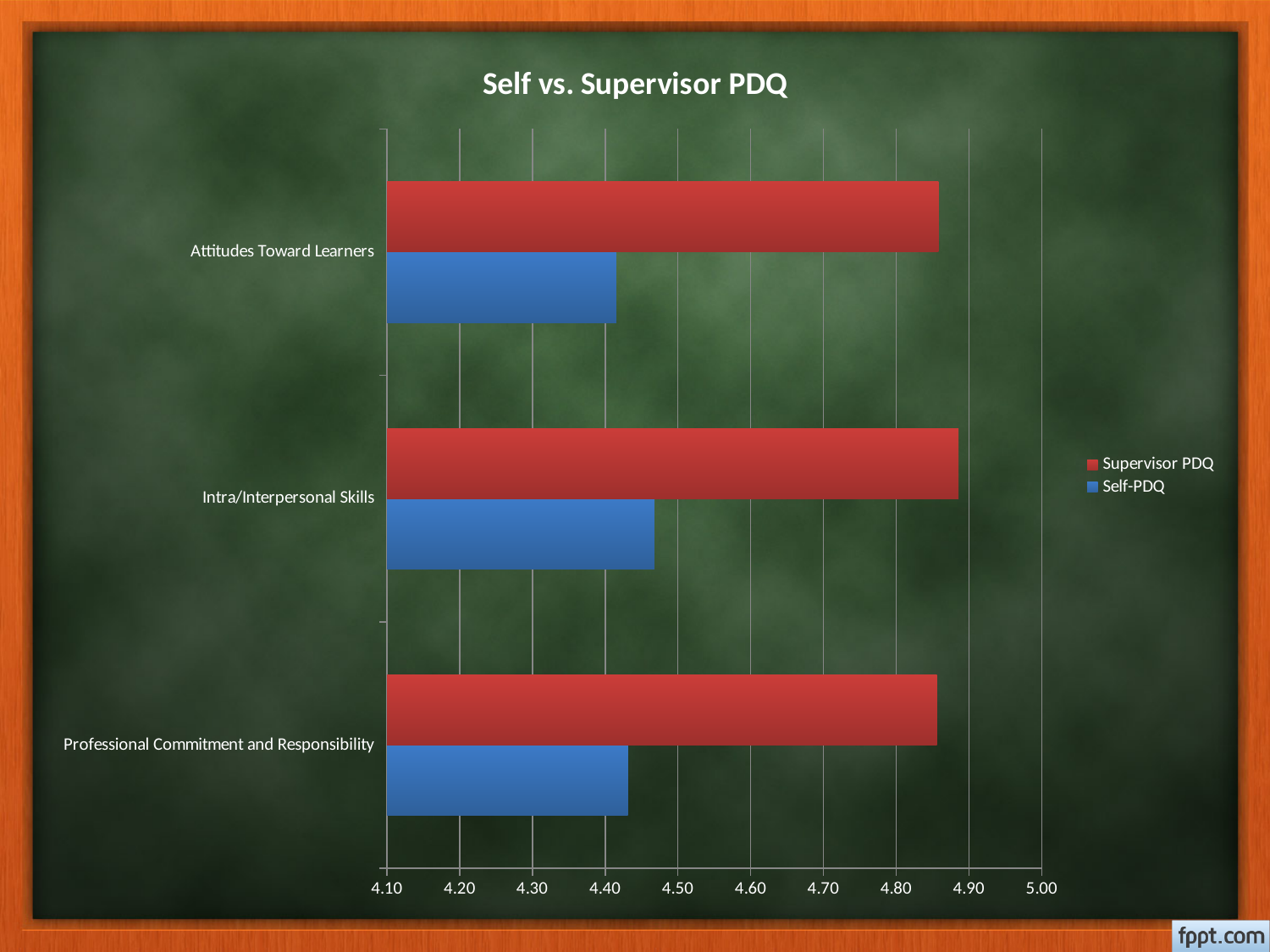
Is the Self-PDQ value for Intra/Interpersonal Skills greater or less than 4.40? greater For Professional Commitment and Responsibility, which is larger: the Self-PDQ value or the Supervisor PDQ value? Supervisor PDQ Is the Supervisor PDQ value for Intra/Interpersonal Skills greater or less than 4.80? greater For Attitudes Toward Learners, which is larger: the Supervisor PDQ value or the Self-PDQ value? Supervisor PDQ Which category has the highest Self-PDQ value? Intra/Interpersonal Skills Which series is shown in red? Supervisor PDQ How many series does the legend list? 2 What is the title of the chart? Self vs. Supervisor PDQ How many categories are shown on the chart? 3 Is the Self-PDQ value for Attitudes Toward Learners greater or less than 4.50? less What kind of chart is shown on the slide? Bar chart